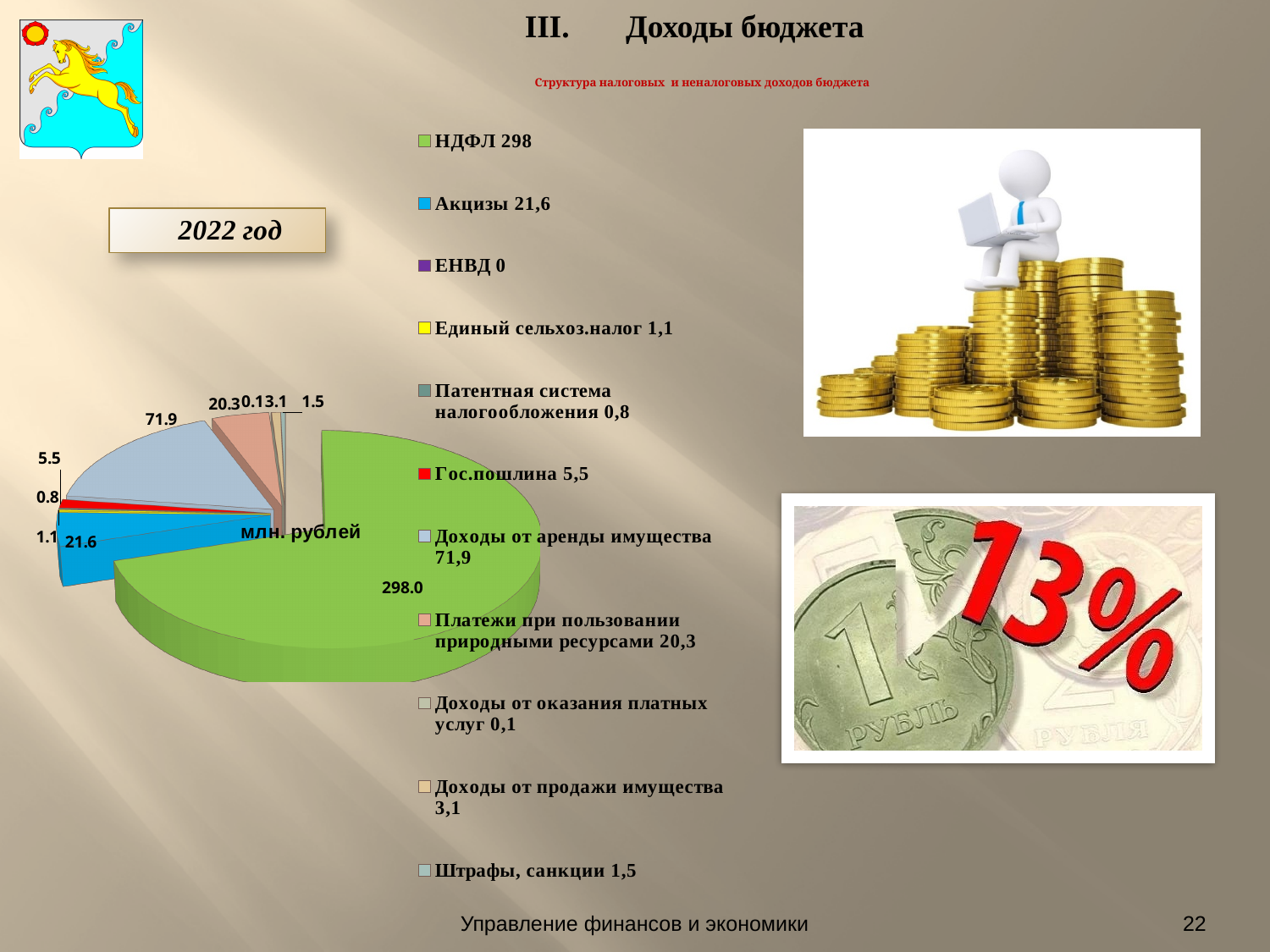
What is the value for Акцизы in the pie chart? 21.6 Which category has the largest slice of the pie? НДФЛ How many categories does the legend list? 11 Which category has the smallest value in the legend? ЕНВД What is the value for Доходы от аренды имущества? 71.9 What is the difference between НДФЛ and Доходы от аренды имущества? 226.1 What is the value for Гос.пошлина? 5.5 Which is larger: Акцизы or Платежи при пользовании природными ресурсами? Акцизы In what units are the values of the pie chart given? млн. рублей What is the value for НДФЛ in the pie chart? 298.0 What kind of chart is shown on the slide? pie chart What is the difference between Доходы от аренды имущества and Акцизы? 50.3